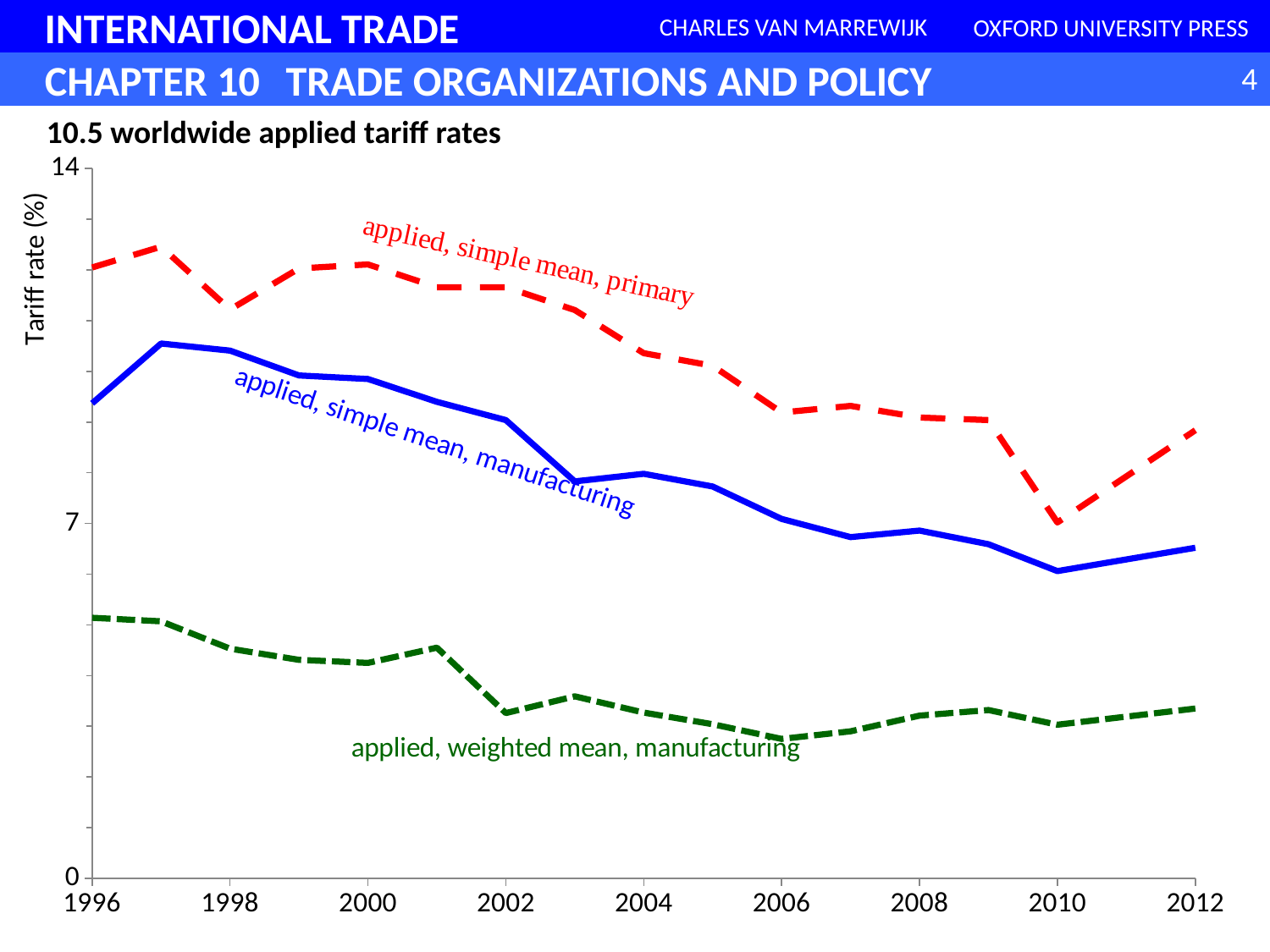
What is the title of the chart? 10.5 worldwide applied tariff rates Which series has the highest tariff rate across the whole period? applied, simple mean, primary Does the applied, simple mean, primary series generally rise or fall between 1996 and 2010? fall What is the label on the vertical axis? Tariff rate (%) How many series are plotted on the chart? 3 Is the value for applied, simple mean, manufacturing in 2010 greater or less than 7? less What kind of chart is shown on the slide? line chart Which series has the lowest tariff rate across the whole period? applied, weighted mean, manufacturing In 2012, which is larger: applied, simple mean, primary or applied, simple mean, manufacturing? applied, simple mean, primary Is the value for applied, simple mean, primary in 1996 greater or less than 7? greater Is the value for applied, weighted mean, manufacturing in 1996 greater or less than 7? less Does the applied, simple mean, manufacturing series rise or fall between 1997 and 2010? fall